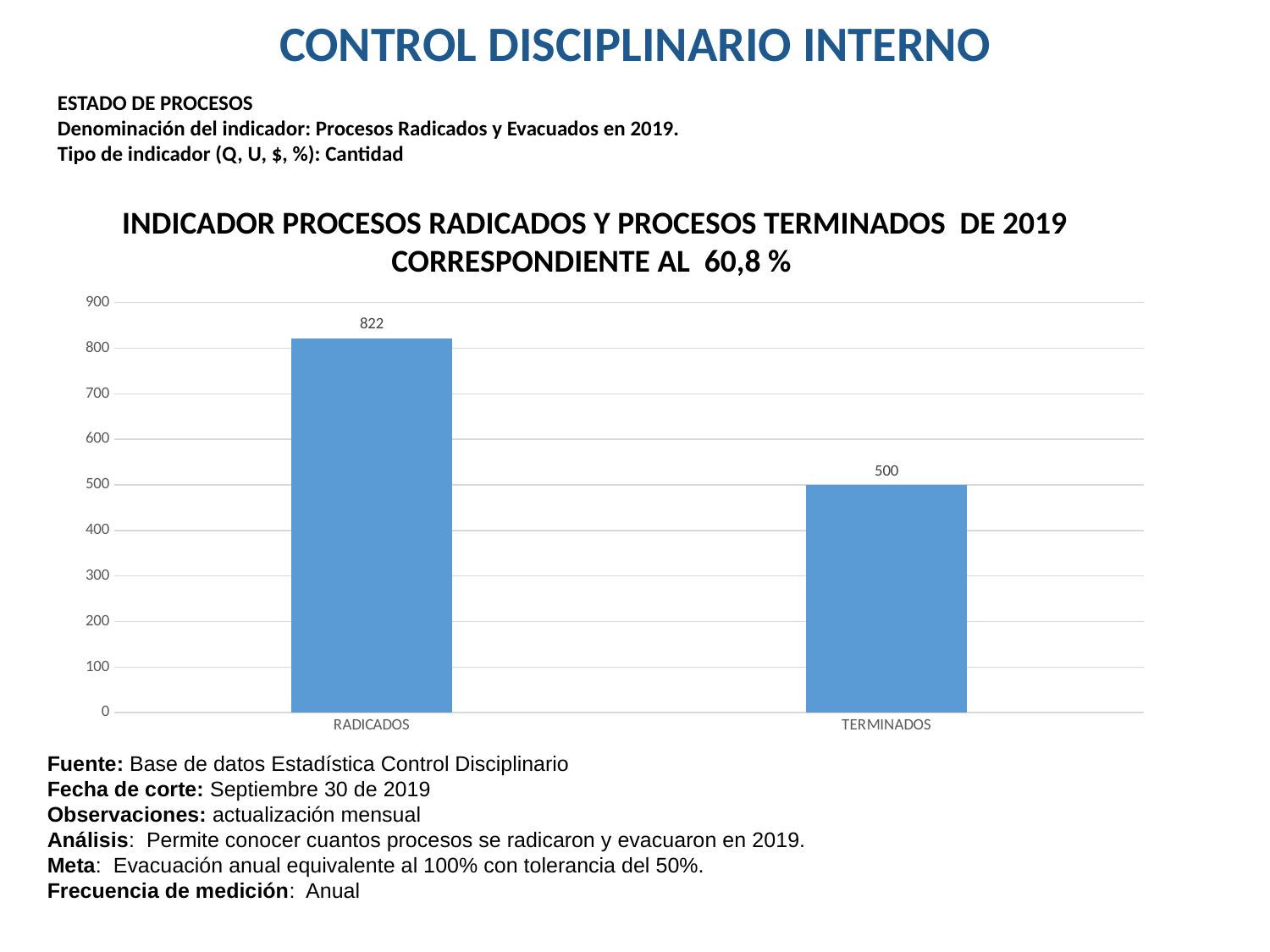
Is the value for RADICADOS greater or less than 700? greater What is the difference between the values for RADICADOS and TERMINADOS? 322 What is the highest value shown on the y axis? 900 What is the value for TERMINADOS? 500 Which category has the highest value? RADICADOS How many categories are shown on the x axis? 2 Which category has the lowest value? TERMINADOS What kind of chart is shown on the slide? bar chart Is the value for TERMINADOS greater or less than 600? less What percentage is stated in the chart title? 60,8 % Which is larger, the value for RADICADOS or the value for TERMINADOS? RADICADOS What is the value for RADICADOS? 822